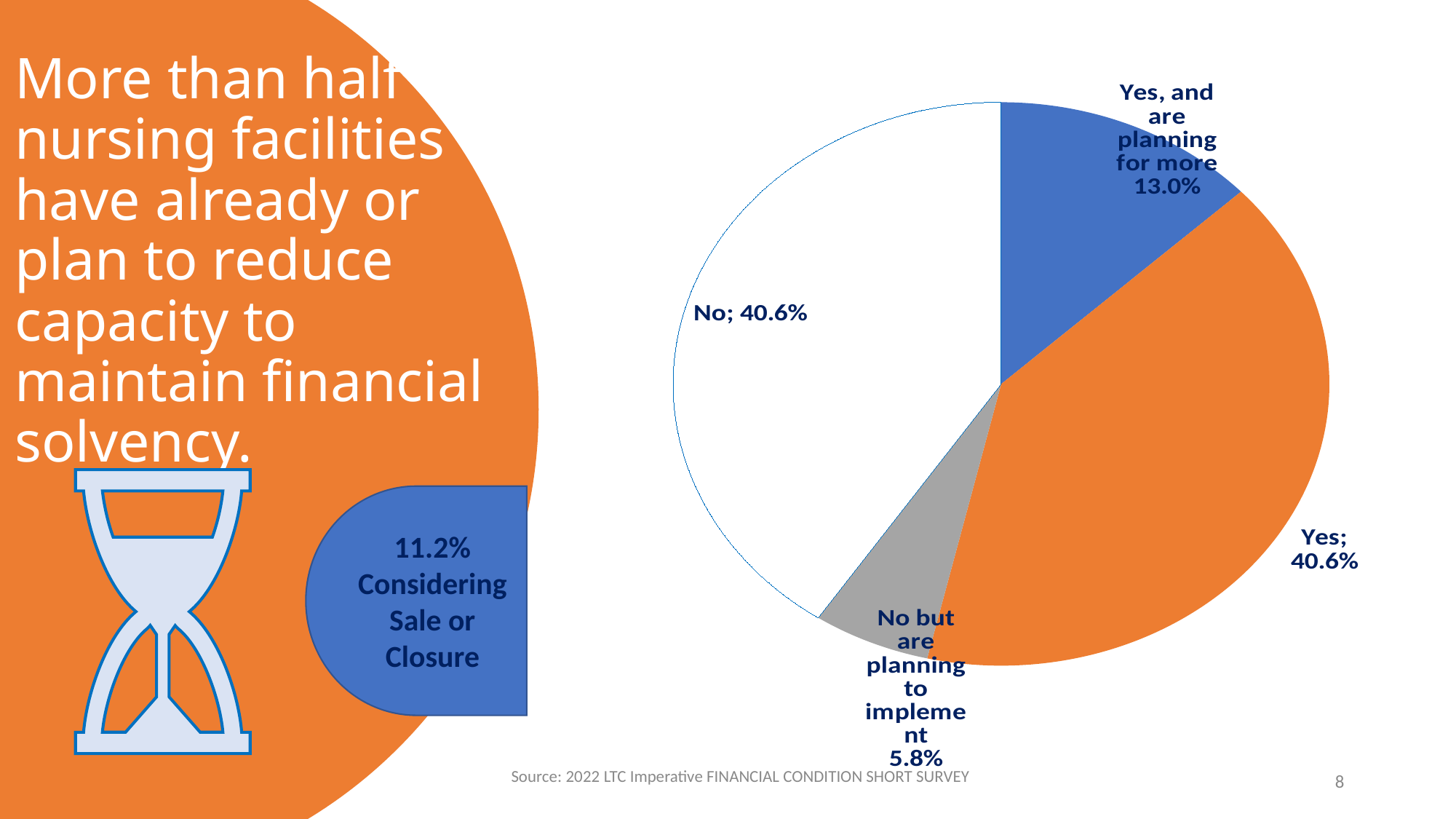
What share of the pie is labelled "Yes, and are planning for more"? 13.0% Which slice of the pie chart is the smallest? No but are planning to implement What colour is the "Yes" slice of the pie chart? orange What is the difference between the "Yes, and are planning for more" share and the "No but are planning to implement" share? 7.2% What is the difference between the "Yes" share and the "Yes, and are planning for more" share? 27.6% What is the combined share of the "Yes" and "Yes, and are planning for more" slices? 53.6% What share of the pie is labelled "Yes"? 40.6% Which is larger: the "Yes, and are planning for more" slice or the "No but are planning to implement" slice? Yes, and are planning for more What share of the pie is labelled "No but are planning to implement"? 5.8% What share of the pie is labelled "No"? 40.6% How many slices does the pie chart have? 4 What kind of chart is shown on the slide? pie chart